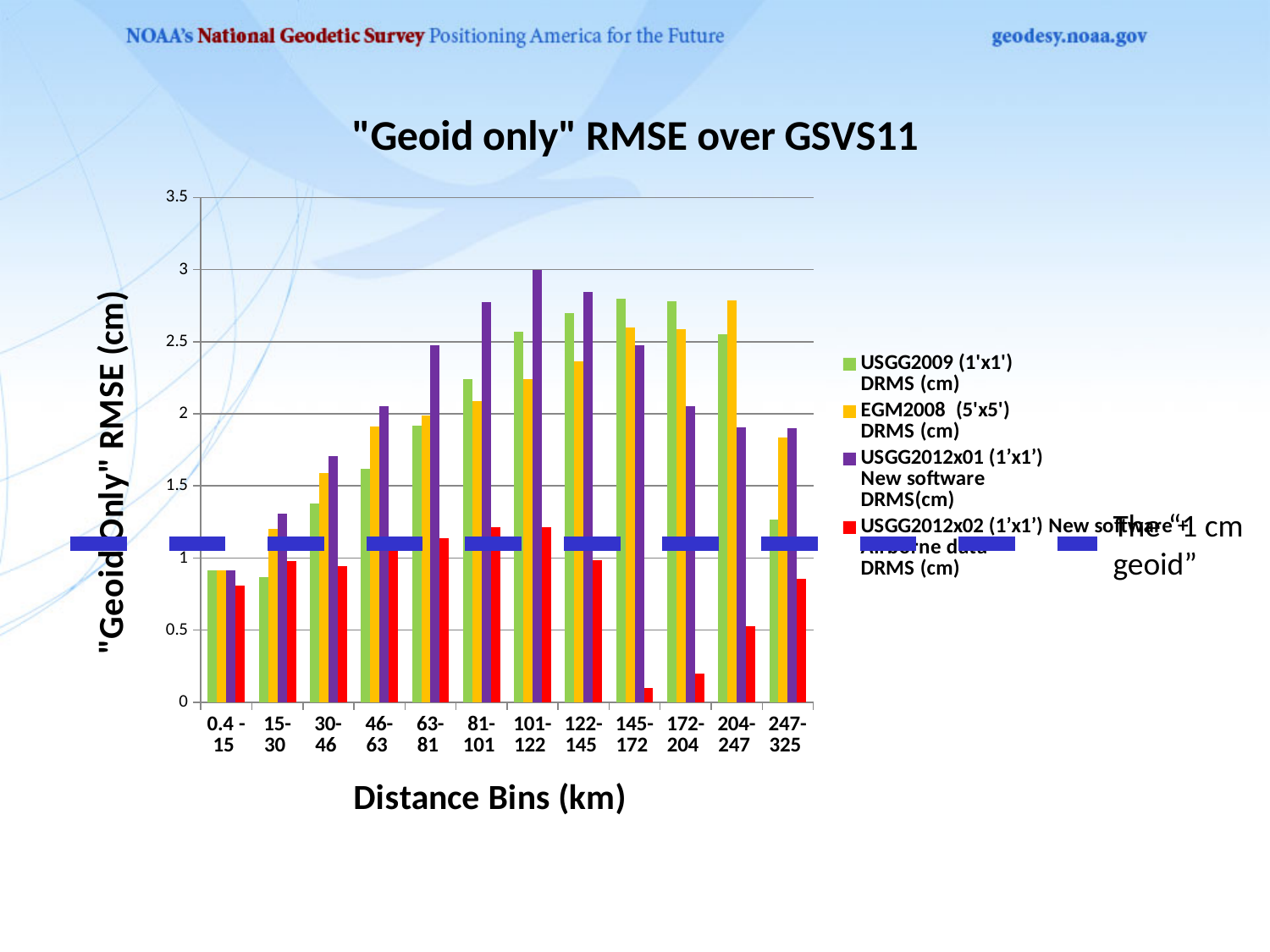
Is the USGG2012x02 value for the 145-172 km bin greater or less than 0.5? less Does the USGG2012x02 series rise or fall from the 101-122 km bin to the 145-172 km bin? fall What kind of chart is shown on the slide? bar chart In the 204-247 km bin, which is larger: the EGM2008 value or the USGG2012x01 value? EGM2008 Is the USGG2009 value for the 145-172 km bin greater or less than 2.5? greater For the USGG2012x02 (1'x1') New software + Airborne data DRMS series, which distance bin has the lowest value? 145-172 In the 63-81 km bin, which is larger: the USGG2009 value or the USGG2012x01 value? USGG2012x01 For the USGG2012x01 (1'x1') New software DRMS series, which distance bin has the highest value? 101-122 How many distance bins are shown on the x axis? 12 Is the USGG2012x01 value for the 101-122 km bin greater or less than 2.5? greater What is the title of the x axis? Distance Bins (km) How many series does the legend list? 4